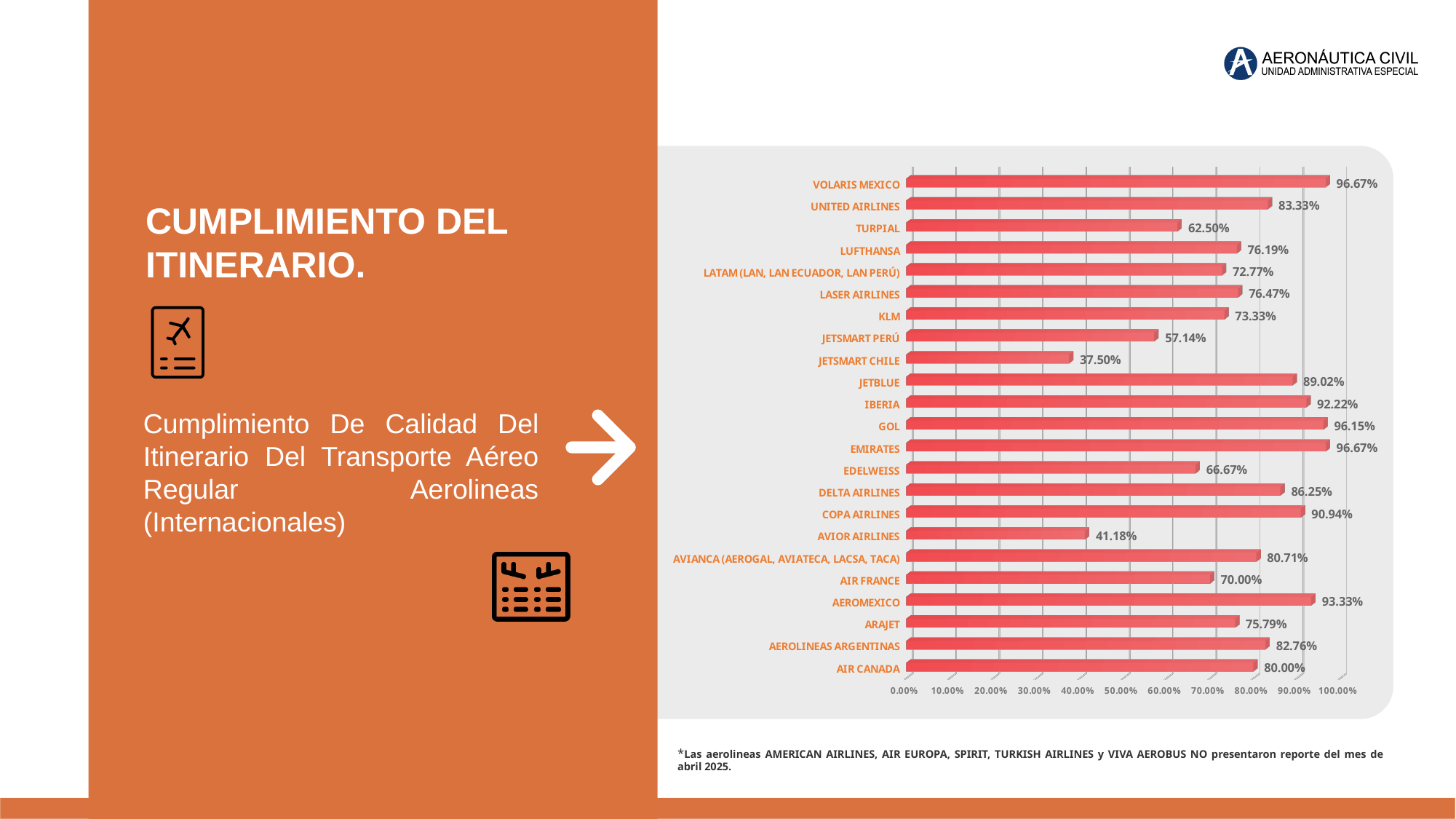
How many airlines are shown in the chart? 23 What is the difference between the values for VOLARIS MEXICO and UNITED AIRLINES? 13.34% What is the value for COPA AIRLINES? 90.94% Which airline has the lowest value in the chart? JETSMART CHILE What is the value for AIR CANADA? 80.00% Which has a higher value, COPA AIRLINES or DELTA AIRLINES? COPA AIRLINES What is the value for VOLARIS MEXICO? 96.67% What kind of chart is shown on the slide? bar chart What is the difference between the values for AIR FRANCE and EDELWEISS? 3.33% Is the value for AVIOR AIRLINES greater or less than 50.00%? less What is the value for JETSMART PERÚ? 57.14% Is the value for AEROMEXICO greater or less than 90.00%? greater